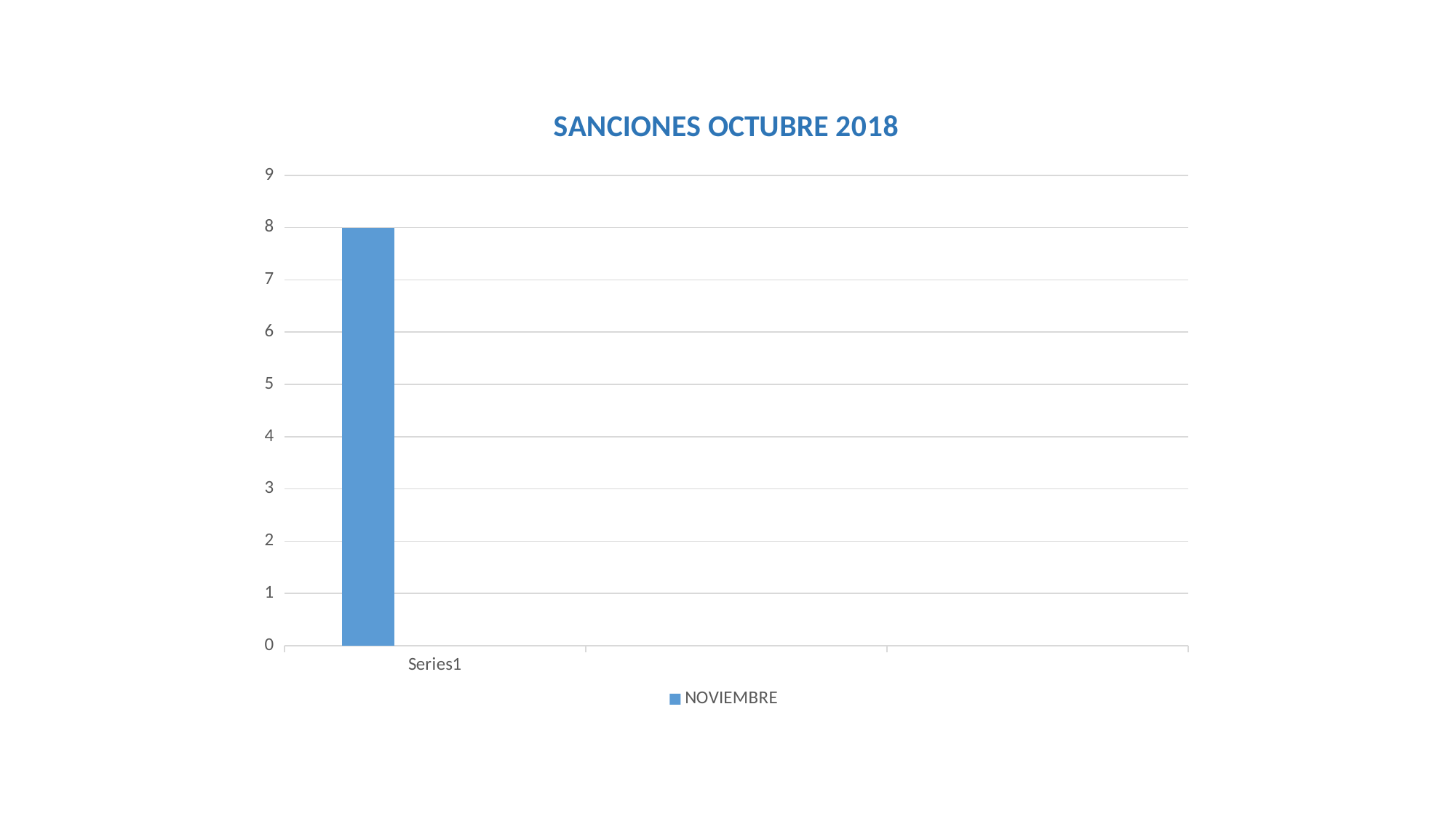
What kind of chart is shown on the slide? bar chart How many series does the legend list? 1 What is the maximum value shown on the vertical axis? 9 What series name appears in the legend? NOVIEMBRE Is the value for Series1 greater or less than 5? greater Is the value for Series1 greater or less than 9? less What is the title of the chart? SANCIONES OCTUBRE 2018 What is the value of the bar for Series1? 8 How many bars are plotted in the chart? 1